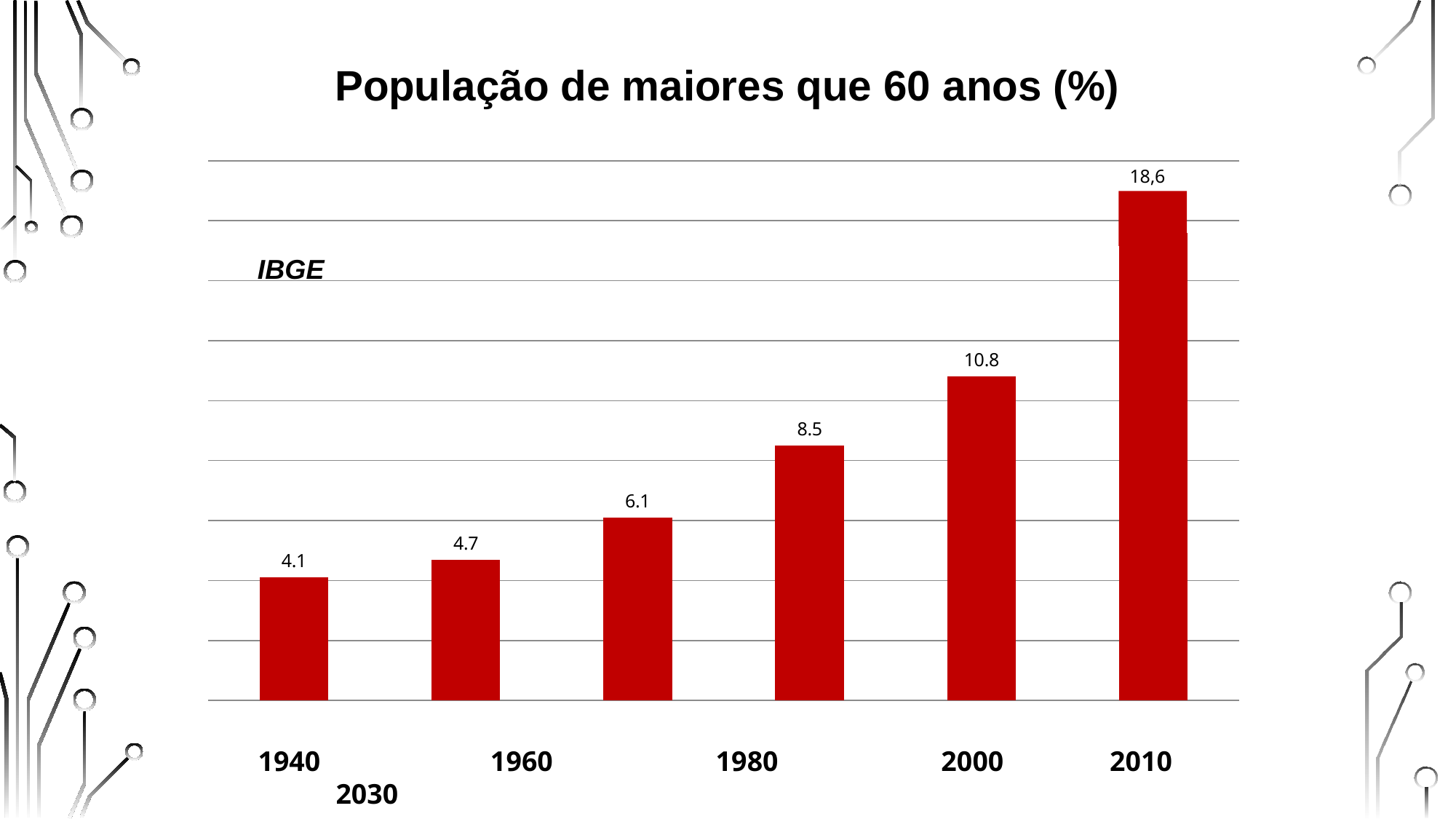
What is the title of the chart? População de maiores que 60 anos (%) What is the difference between the values for 2010 and 2000? 7.8 What is the value shown for 2000? 10.8 What is the value of the third bar from the left? 6.1 Do the values rise or fall from left to right along the x axis? Rise What is the value shown for 1940? 4.1 Which bar has the highest value? 2010 What type of chart is shown on the slide? Bar chart How many bars are plotted in the chart? 6 What is the value of the fourth bar from the left? 8.5 Which bar has the lowest value? 1940 What is the value shown for 2010? 18,6